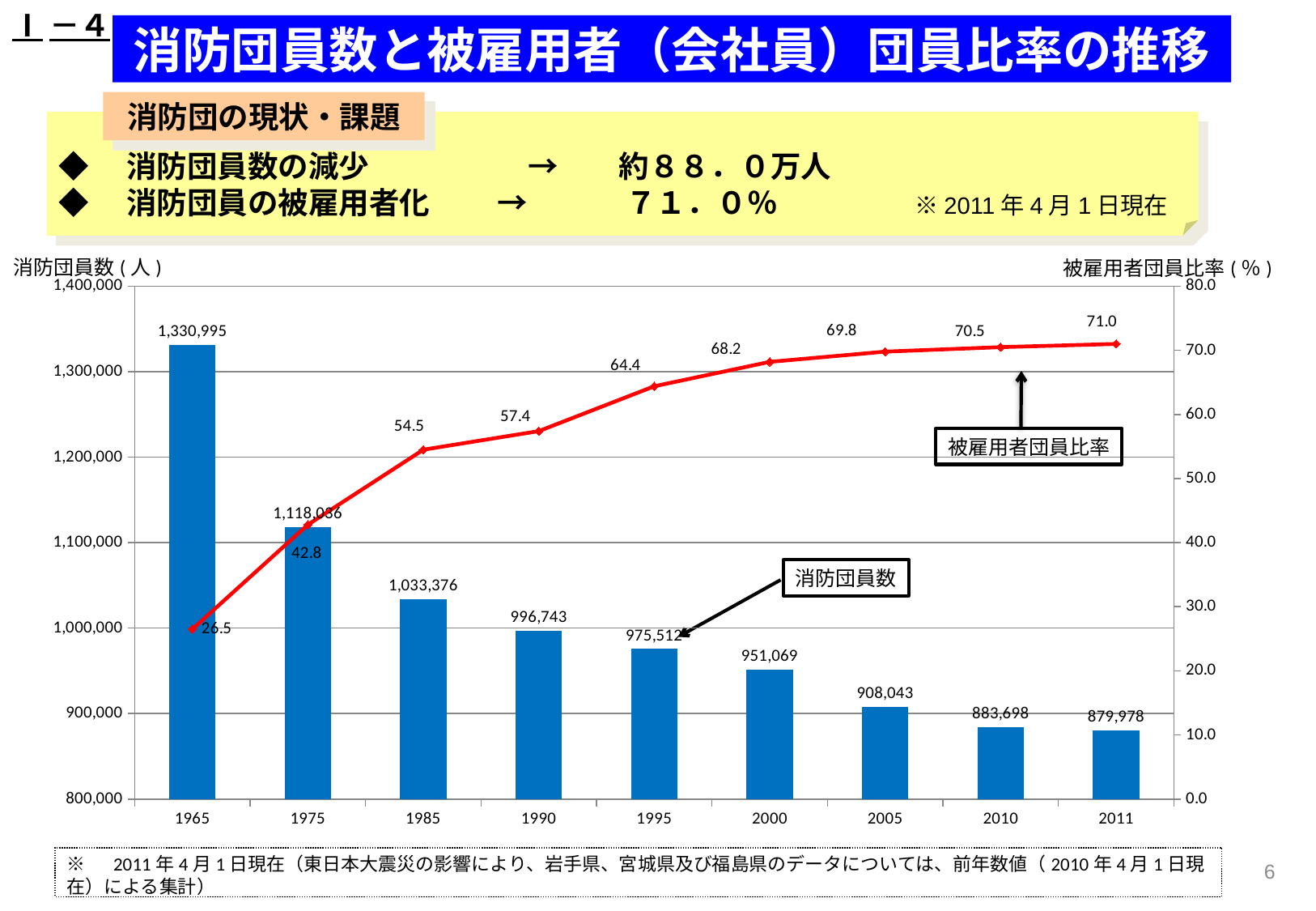
What is the employee member ratio (被雇用者団員比率) shown for 1995? 64.4 In which year is the number of fire corps members the highest? 1965 Which year has more fire corps members, 1990 or 1995? 1990 What is the number of fire corps members (消防団員数) shown for 1965? 1,330,995 What is the employee member ratio (被雇用者団員比率) shown for 1965? 26.5 In which year is the employee member ratio the lowest? 1965 How does the number of fire corps members change from 1965 to 2011? It falls What is the number of fire corps members (消防団員数) shown for 2011? 879,978 By how many percentage points did the employee member ratio rise from 1965 to 2011? 44.5 Is the number of fire corps members in 2000 greater or less than 1,000,000? less How many years are shown on the x axis of the chart? 9 What is the difference between the number of fire corps members in 1965 and in 2011? 451,017